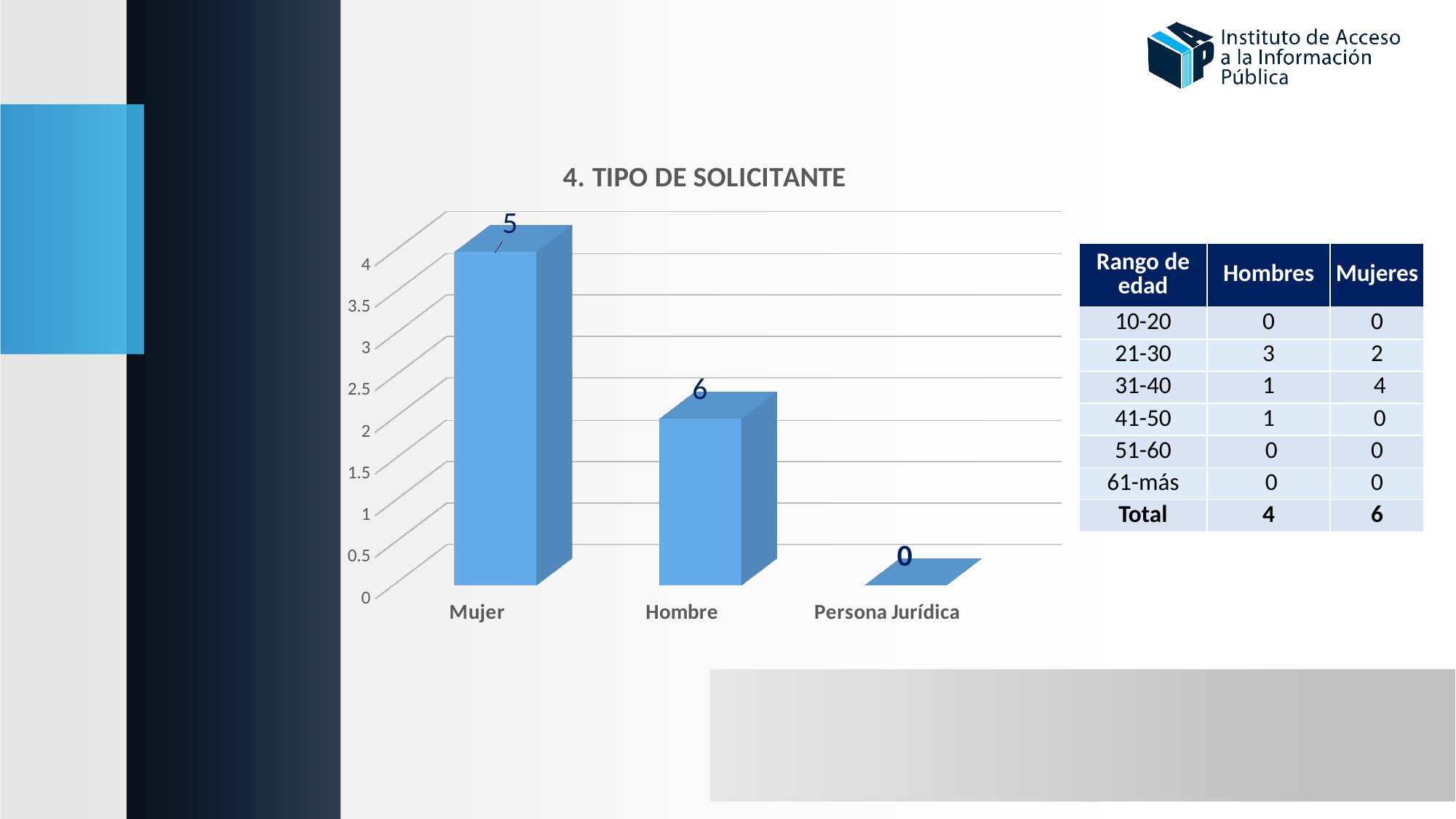
What is the highest tick value shown on the vertical axis of the chart? 4 What is the data label shown for Mujer in the chart? 5 Which category has the lowest value in the chart? Persona Jurídica Is the value for Persona Jurídica greater or less than 1? less How many categories are shown on the x axis of the chart? 3 What kind of chart is shown on the slide? Bar chart What is the data label shown for Persona Jurídica in the chart? 0 What is the title of the chart? 4. TIPO DE SOLICITANTE What is the data label shown for Hombre in the chart? 6